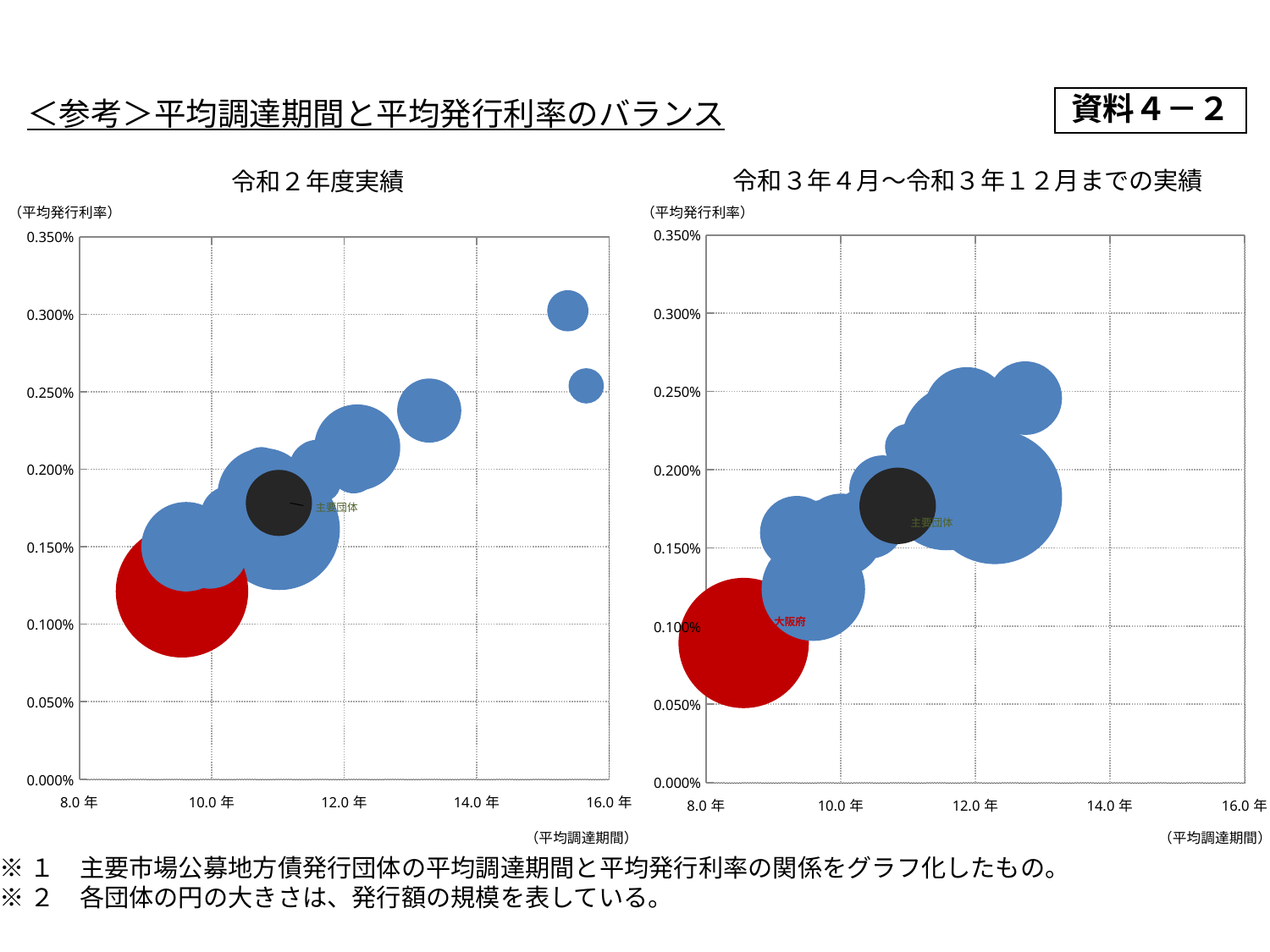
In the left chart (令和２年度実績), is the 平均発行利率 value for 主要団体 greater or less than 0.150%? greater In the left chart (令和２年度実績), which has the longer 平均調達期間, 主要団体 or 大阪府? 主要団体 In the left chart (令和２年度実績), what colour is the bubble labelled 主要団体? Black In the left chart (令和２年度実績), is the 平均発行利率 value for the red bubble (大阪府) greater or less than 0.150%? less In the right chart (令和３年４月～令和３年１２月までの実績), is the 平均発行利率 value for 大阪府 greater or less than 0.150%? less What is the highest value shown on the vertical axis of the right chart (令和３年４月～令和３年１２月までの実績)? 0.350% In the right chart (令和３年４月～令和３年１２月までの実績), which has the higher 平均発行利率, 主要団体 or 大阪府? 主要団体 What is the title of the chart on the right side of the slide? 令和３年４月～令和３年１２月までの実績 What kind of chart is shown on the left side of the slide (令和２年度実績)? Bubble chart In the left chart (令和２年度実績), do the 平均発行利率 values of the bubbles generally rise or fall as 平均調達期間 increases? Rise How many charts are shown on the slide? 2